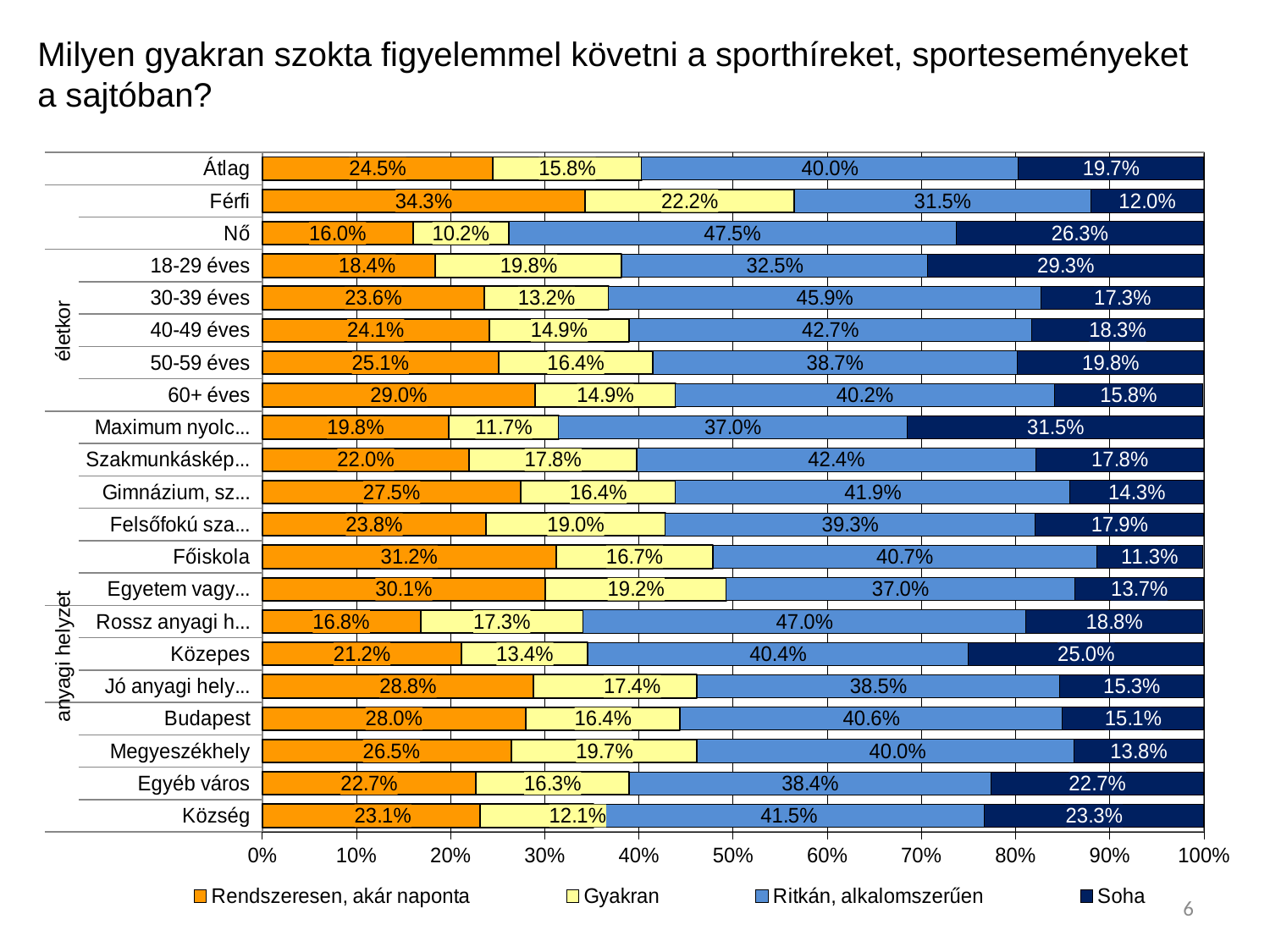
How many series does the legend list? 4 What is the value of "Ritkán, alkalomszerűen" for 30-39 éves? 45.9% What is the value of "Rendszeresen, akár naponta" for Férfi? 34.3% What is the value of "Soha" for Nő? 26.3% How many categories are shown on the chart? 21 Which series is shown in dark blue in the legend? Soha What kind of chart is shown on the slide? Stacked bar chart What is the difference between the "Soha" values for Férfi and Nő? 14.3% Which category has the lowest value for "Gyakran"? Nő Which is larger: the "Rendszeresen, akár naponta" value for 60+ éves or for 18-29 éves? 60+ éves What is the value of "Gyakran" for Budapest? 16.4% Which category has the highest value for "Rendszeresen, akár naponta"? Férfi